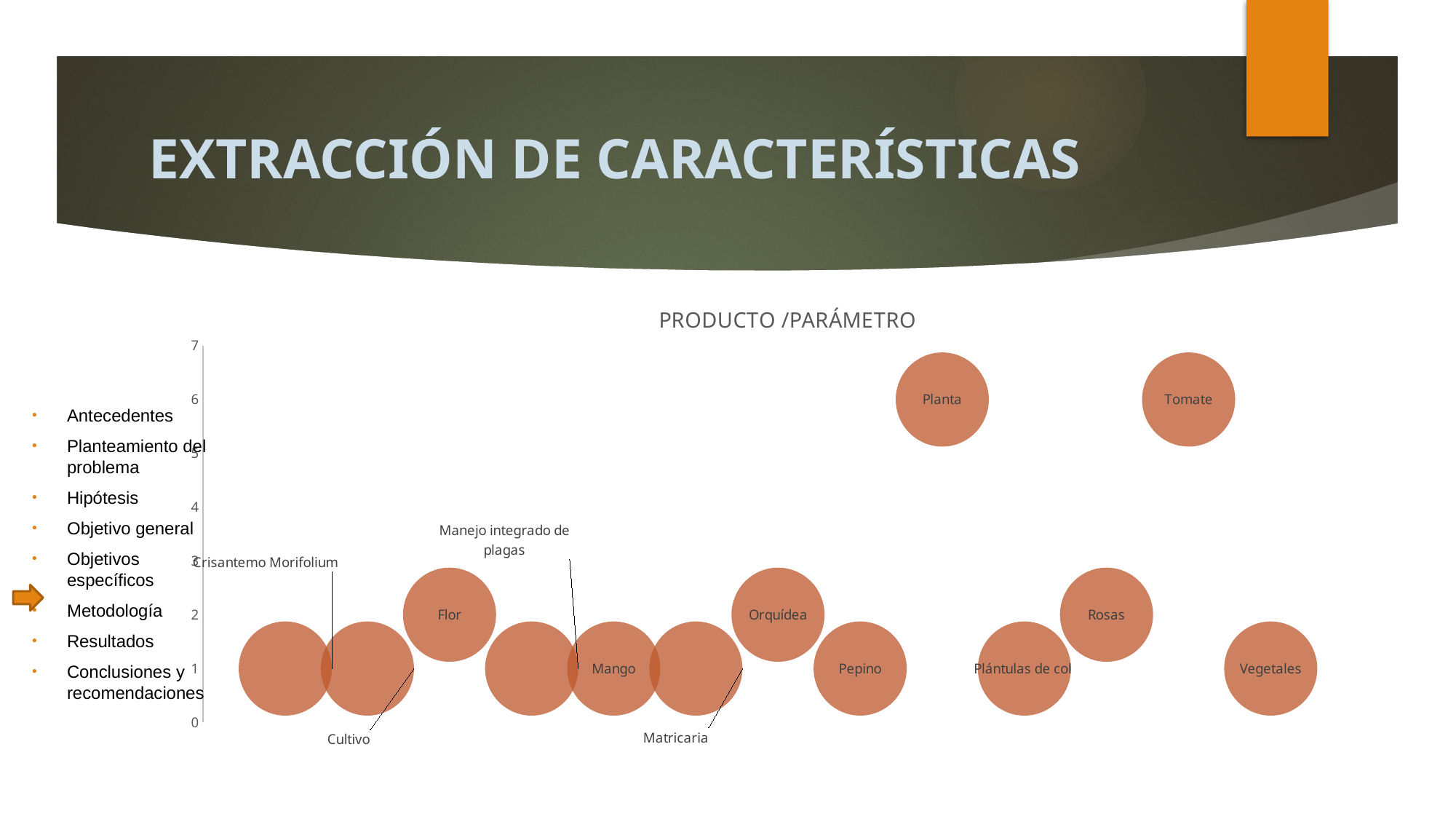
What is the title of the chart? PRODUCTO /PARÁMETRO What kind of chart is shown on the slide? bubble chart Which is positioned higher on the vertical axis, Rosas or Vegetales? Rosas Which two bubbles are positioned highest on the vertical axis? Planta and Tomate Is the value for Pepino greater or less than 3? less What value on the vertical axis does the Tomate bubble sit at? 6 What value on the vertical axis does the Mango bubble sit at? 1 What value on the vertical axis does the Flor bubble sit at? 2 Is the value for Planta greater or less than 4? greater What value on the vertical axis does the Planta bubble sit at? 6 What is the highest value shown on the vertical axis? 7 Which is positioned higher on the vertical axis, Planta or Mango? Planta